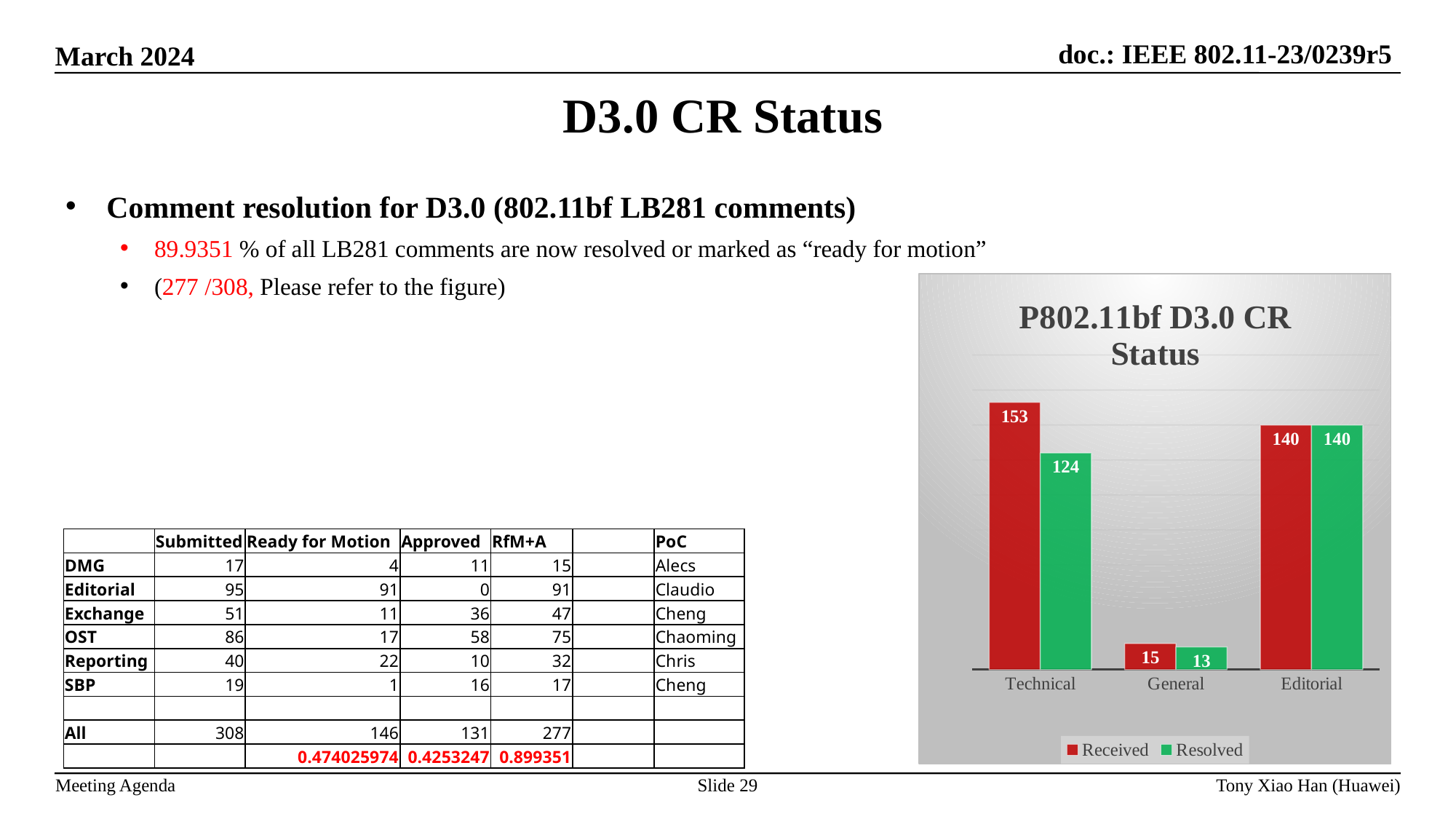
What is the Resolved value for Editorial? 140 What is the Received value for Technical? 153 Which category has the highest Received value? Technical What is the difference between Received and Resolved for Technical? 29 Which is larger, the Resolved value for Technical or the Resolved value for Editorial? Editorial How many categories are shown on the x axis? 3 How many series does the legend list? 2 What is the Received value for General? 15 What is the Resolved value for Technical? 124 Which category has the lowest Resolved value? General What type of chart is shown? Bar chart What is the difference between Received and Resolved for General? 2